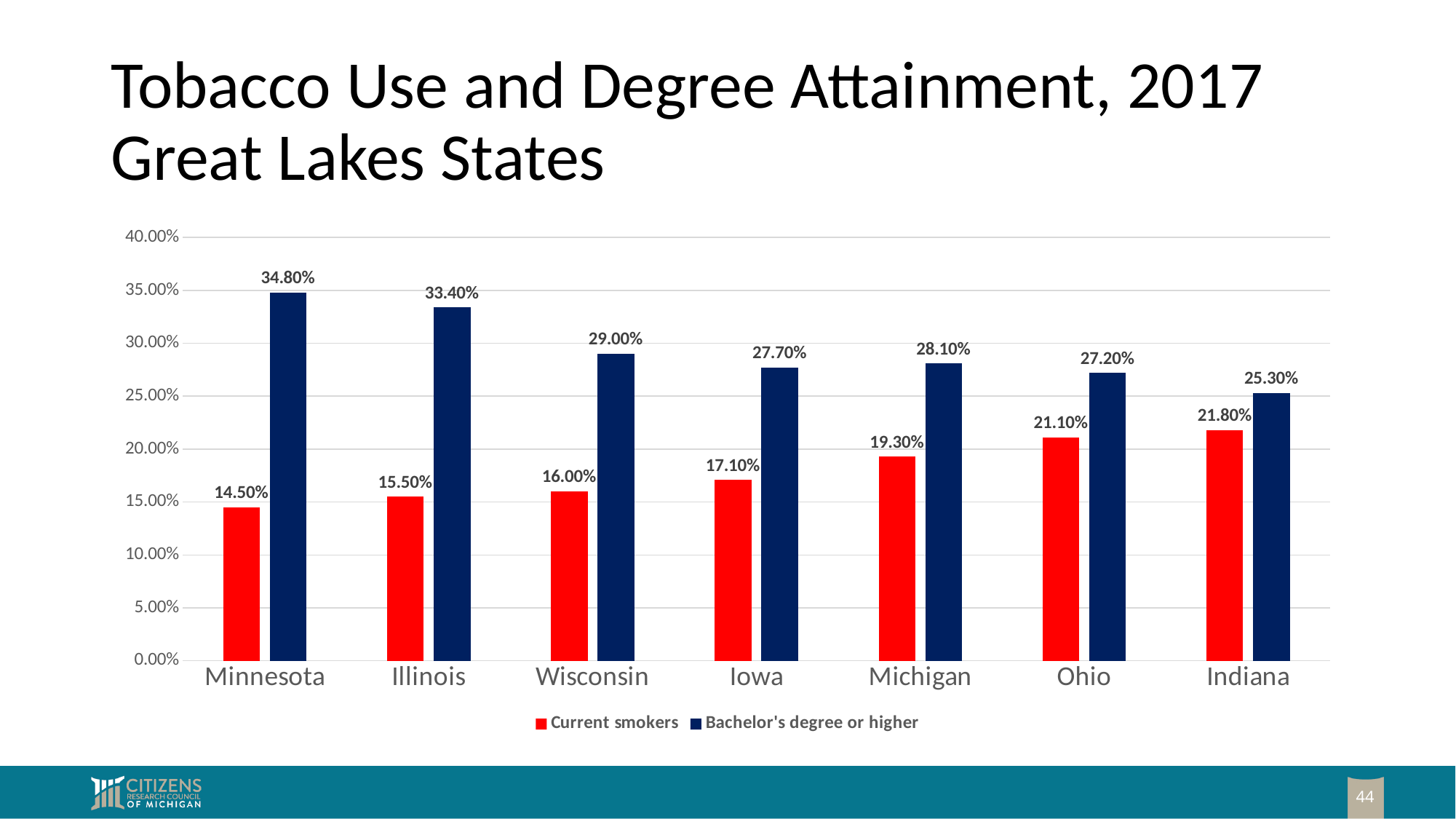
What is the value for Current smokers in Indiana? 21.80% How many series does the legend list? 2 Which is larger: the Current smokers value for Iowa or for Wisconsin? Iowa What is the value for Current smokers in Michigan? 19.30% How many states are shown on the x axis? 7 What kind of chart is shown on the slide? Bar chart What is the value for Bachelor's degree or higher in Minnesota? 34.80% Which state has the lowest value for Current smokers? Minnesota Do the Current smokers values rise or fall from Minnesota to Indiana along the x axis? Rise What is the difference between the Bachelor's degree or higher value and the Current smokers value for Ohio? 6.10% Which state has the highest value for Bachelor's degree or higher? Minnesota Which state has the lowest value for Bachelor's degree or higher? Indiana